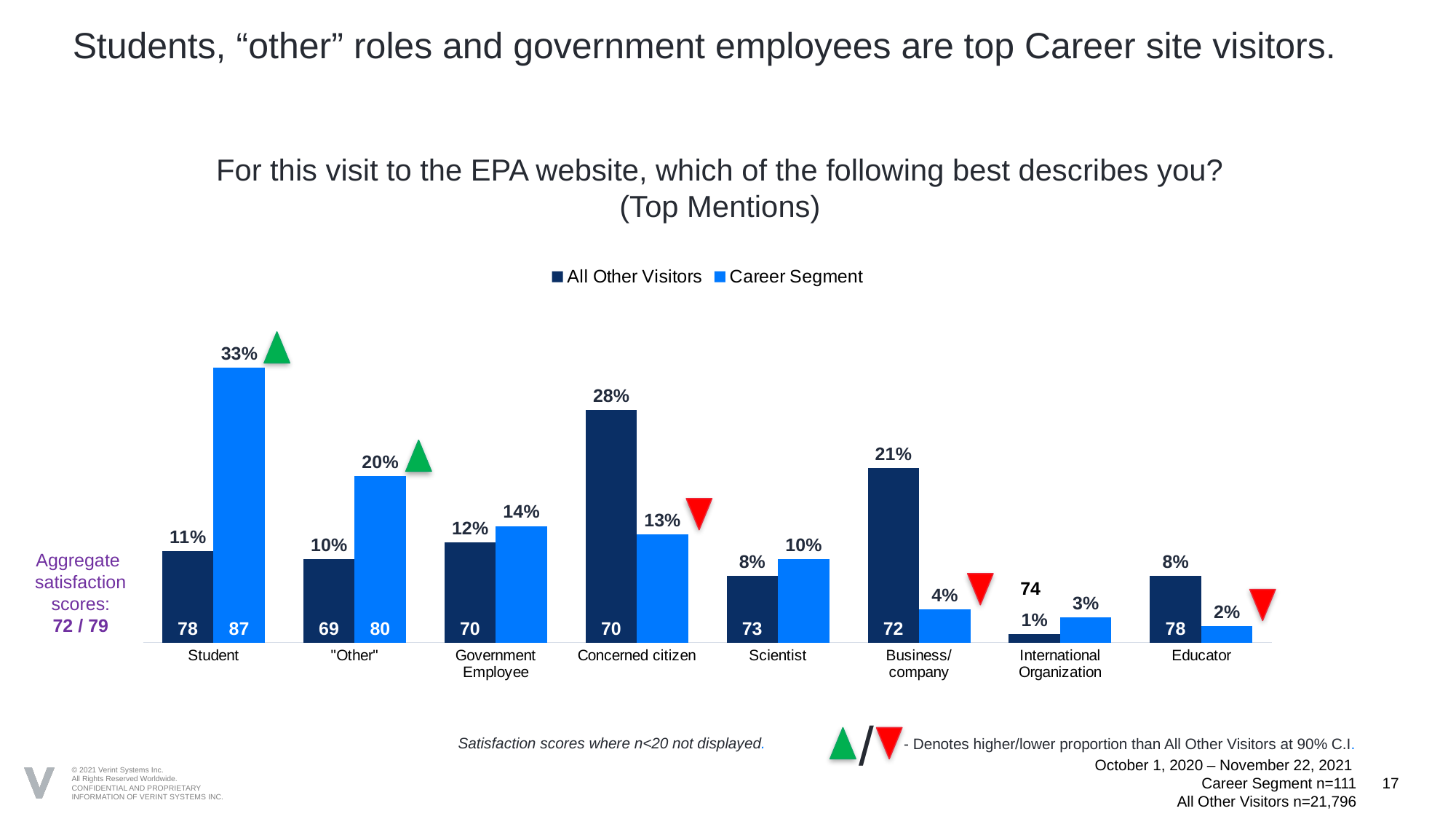
What kind of chart is shown on the slide? Bar chart What is the Career Segment value for Business/company? 4% How many categories are shown on the x axis? 8 What is the aggregate satisfaction score shown for the Career Segment in the Student category? 87 How many series does the legend list? 2 Which category has the highest value for the Career Segment series? Student For Concerned citizen, which series has the larger value, All Other Visitors or Career Segment? All Other Visitors Which series is shown in dark navy in the legend? All Other Visitors What is the difference between the Career Segment and All Other Visitors values for Student? 22% Which category has the lowest value for All Other Visitors? International Organization What percentage of the Career Segment selected Student? 33% What percentage of All Other Visitors selected Concerned citizen? 28%